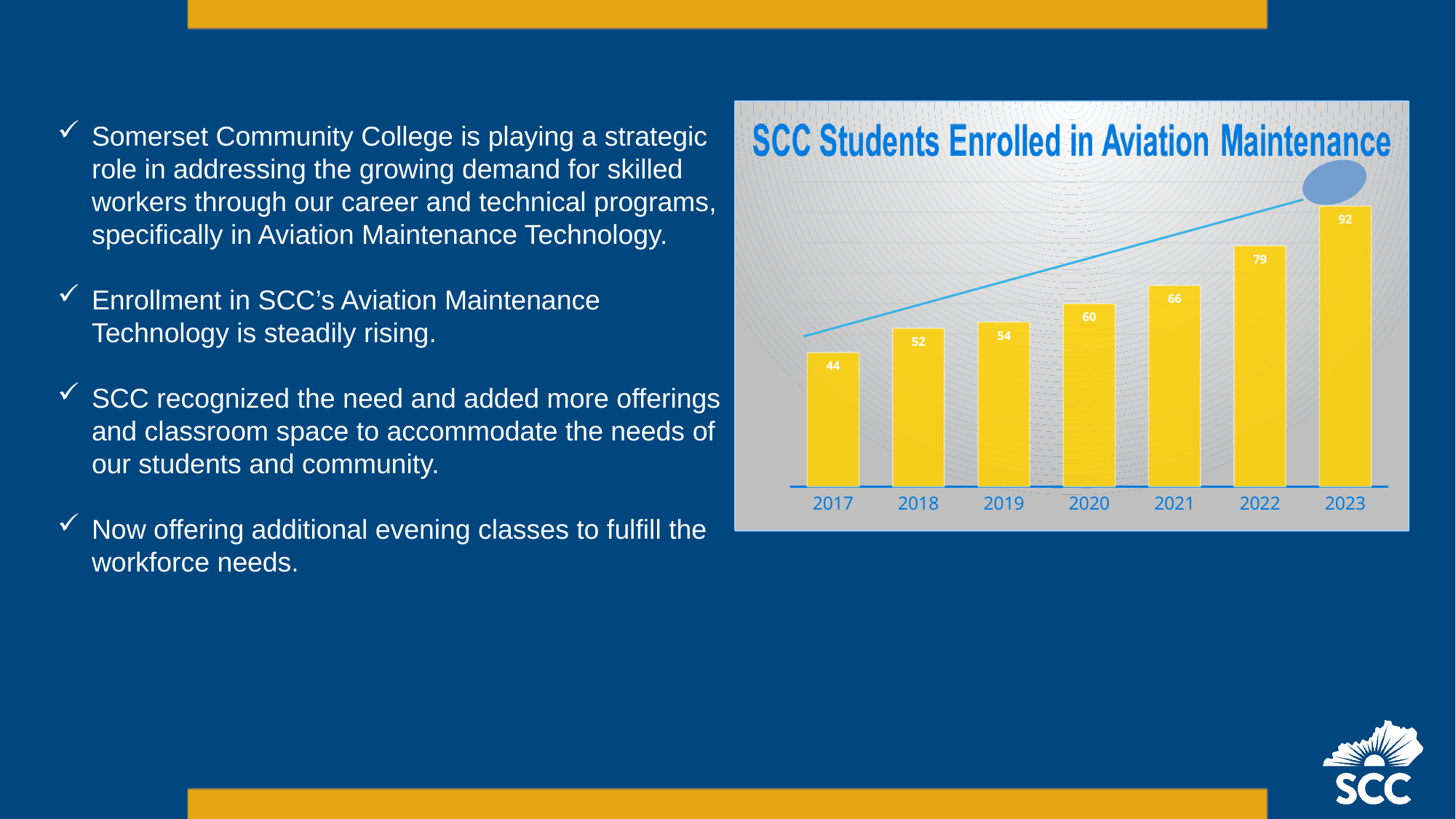
Which year has the lowest enrollment? 2017 What is the difference between the 2022 and 2021 values? 13 What is the difference between the 2023 and 2017 values? 48 Which is larger, the value for 2019 or the value for 2018? 2019 Do the values rise or fall from 2017 to 2023? Rise How many students were enrolled in Aviation Maintenance in 2017? 44 What is the value shown for 2023? 92 What is the title of the chart? SCC Students Enrolled in Aviation Maintenance How many years are shown on the x axis? 7 What kind of chart is shown? Bar chart What is the value shown for 2020? 60 Which year has the highest enrollment? 2023